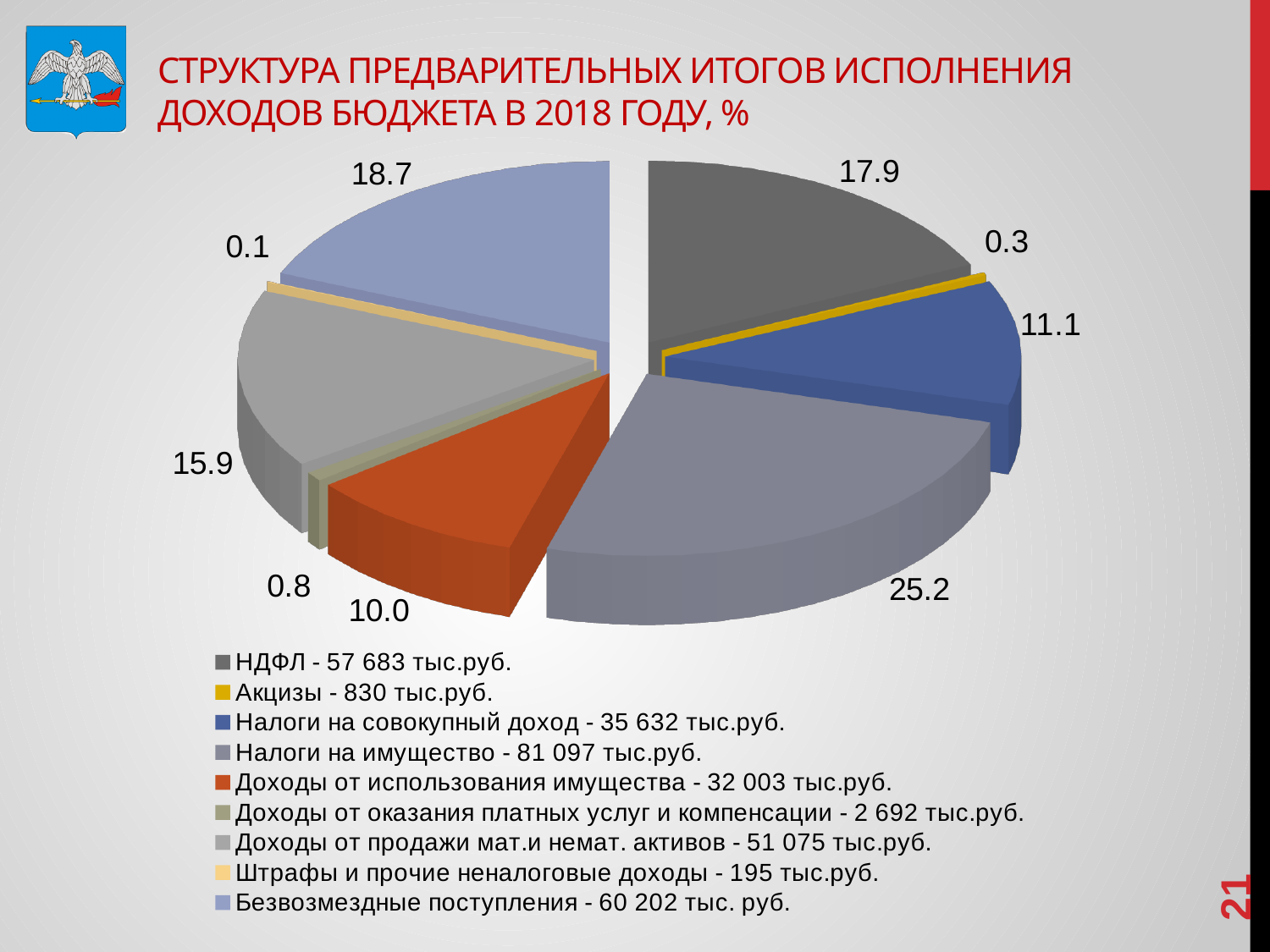
Which is larger, the value for Безвозмездные поступления or the value for Доходы от продажи мат.и немат. активов? Безвозмездные поступления Which category has the smallest slice of the pie? Штрафы и прочие неналоговые доходы How many entries does the legend list? 9 What is the value shown for Налоги на имущество? 25.2 What kind of chart is shown on the slide? pie chart What is the value shown for Доходы от использования имущества? 10.0 What is the difference between the values for Налоги на имущество and Налоги на совокупный доход? 14.1 What is the value shown for Безвозмездные поступления? 18.7 What is the value shown for НДФЛ? 17.9 How many slices does the pie chart have? 9 What amount in тыс.руб. does the legend give for Акцизы? 830 тыс.руб. Which category has the largest slice of the pie? Налоги на имущество